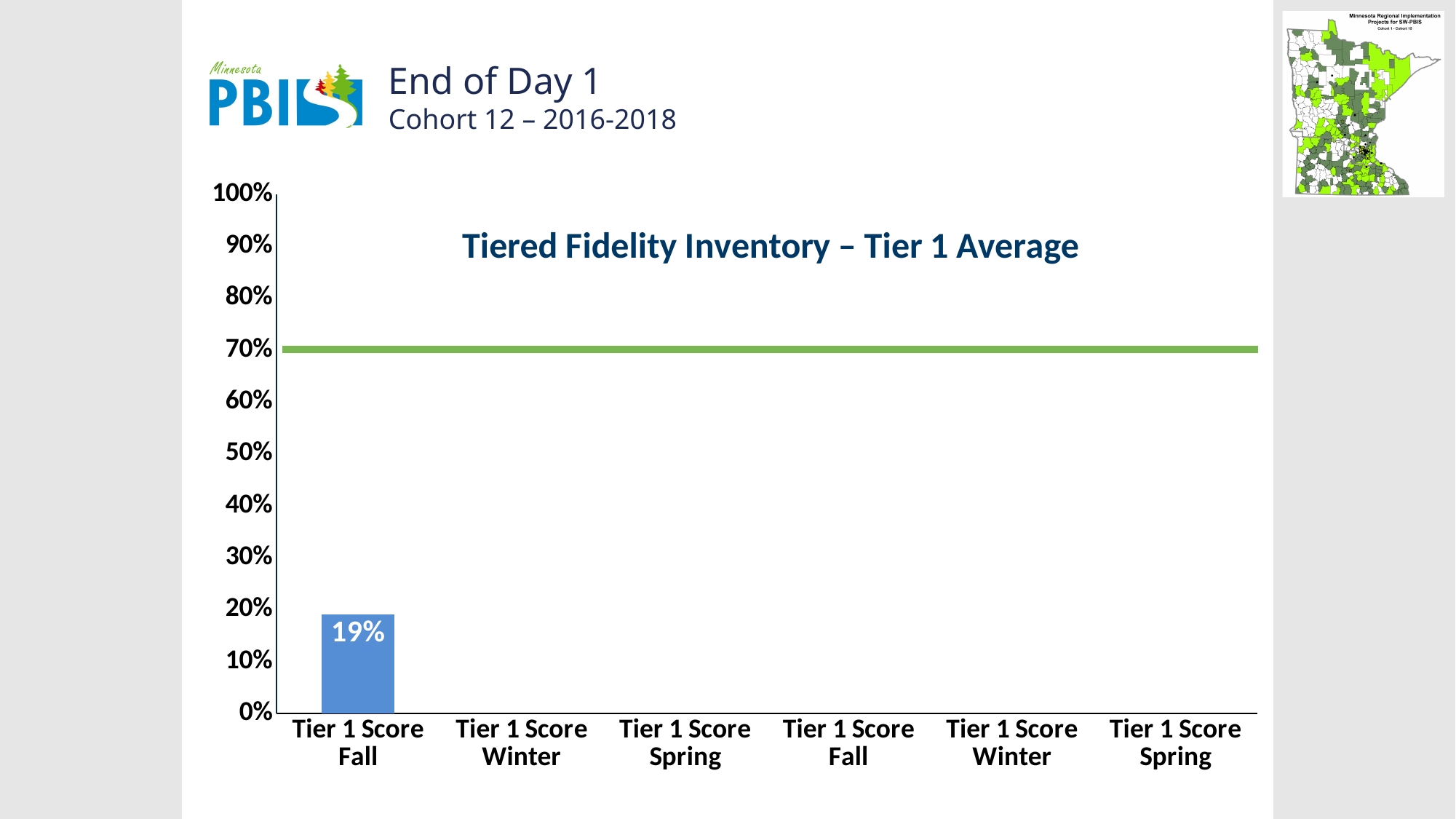
At what percentage does the green horizontal line sit on the chart? 70% Is the value for the first Tier 1 Score Fall bar greater or less than 70%? less How far below the 70% green line is the first Tier 1 Score Fall bar? 51% What is the title of the chart? Tiered Fidelity Inventory – Tier 1 Average What kind of chart is shown on the slide? bar chart Which category is the only one with a plotted bar on the chart? Tier 1 Score Fall (first) How many categories are labelled along the x axis of the chart? 6 What is the highest value shown on the y axis of the chart? 100% Is the value for the first Tier 1 Score Fall bar greater or less than 10%? greater What is the value of the first Tier 1 Score Fall bar? 19%